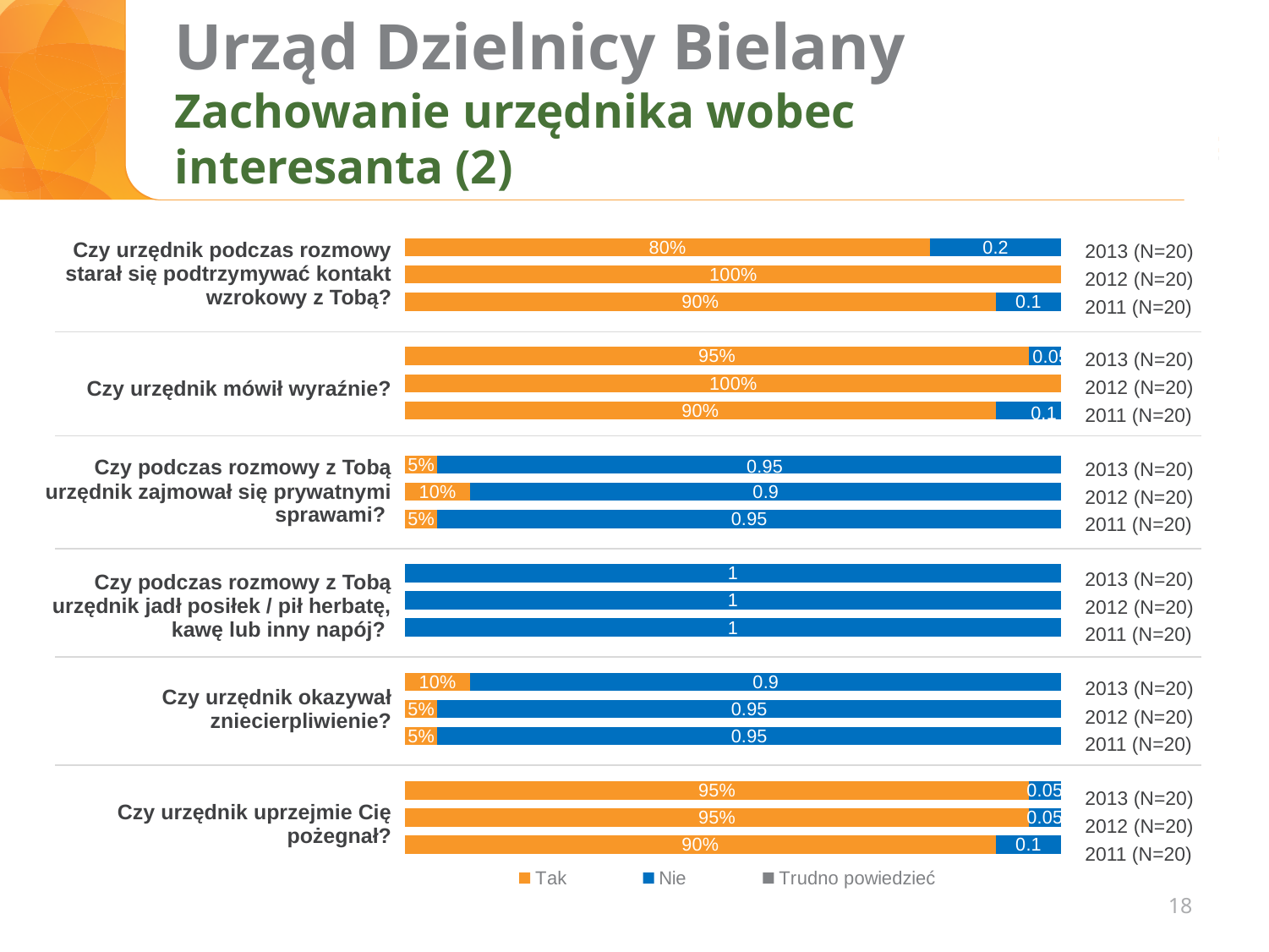
How many survey questions are shown in the chart? 6 What kind of chart is shown on the slide? Stacked bar chart What share answered "Tak" in 2012 (N=20) to "Czy urzędnik mówił wyraźnie?"? 100% How many series does the legend list? 3 What is the "Nie" value shown for each year for "Czy podczas rozmowy z Tobą urzędnik jadł posiłek / pił herbatę, kawę lub inny napój?"? 1 What "Tak" share is shown for 2011 (N=20) for "Czy urzędnik uprzejmie Cię pożegnał?"? 90% What "Tak" share is shown for 2013 (N=20) for "Czy urzędnik okazywał zniecierpliwienie?"? 10% What is the "Nie" value for 2012 (N=20) for "Czy podczas rozmowy z Tobą urzędnik zajmował się prywatnymi sprawami?"? 0.9 For "Czy urzędnik podczas rozmowy starał się podtrzymywać kontakt wzrokowy z Tobą?", which year has the highest "Tak" share? 2012 (N=20) What is the "Nie" value shown for 2013 (N=20) for "Czy urzędnik podczas rozmowy starał się podtrzymywać kontakt wzrokowy z Tobą?"? 0.2 What share of respondents answered "Tak" in 2013 (N=20) to "Czy urzędnik podczas rozmowy starał się podtrzymywać kontakt wzrokowy z Tobą?"? 80% For "Czy urzędnik okazywał zniecierpliwienie?", is the "Tak" share larger in 2013 (N=20) or in 2012 (N=20)? 2013 (N=20)